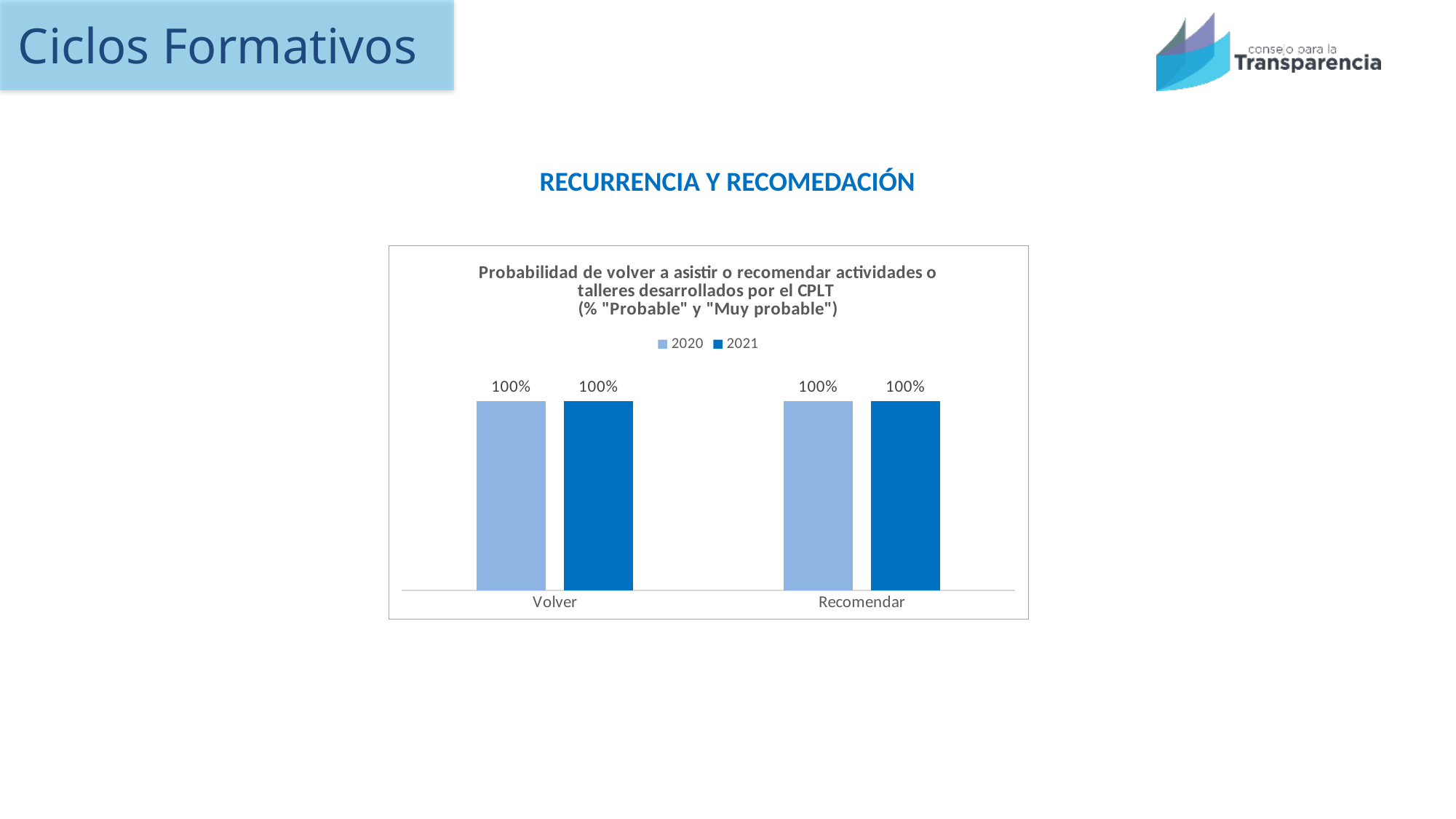
How many categories are shown on the x axis? 2 What is the value for Recomendar in 2021? 100% Which years are listed in the legend? 2020 and 2021 How many series does the legend list? 2 What is the difference between the 2020 and 2021 values for Recomendar? 0% What is the value for Recomendar in 2020? 100% What is the value for Volver in 2020? 100% What kind of chart is shown? Bar chart What are the two categories on the x axis? Volver and Recomendar What is the value for Volver in 2021? 100% What is the difference between the 2020 and 2021 values for Volver? 0%